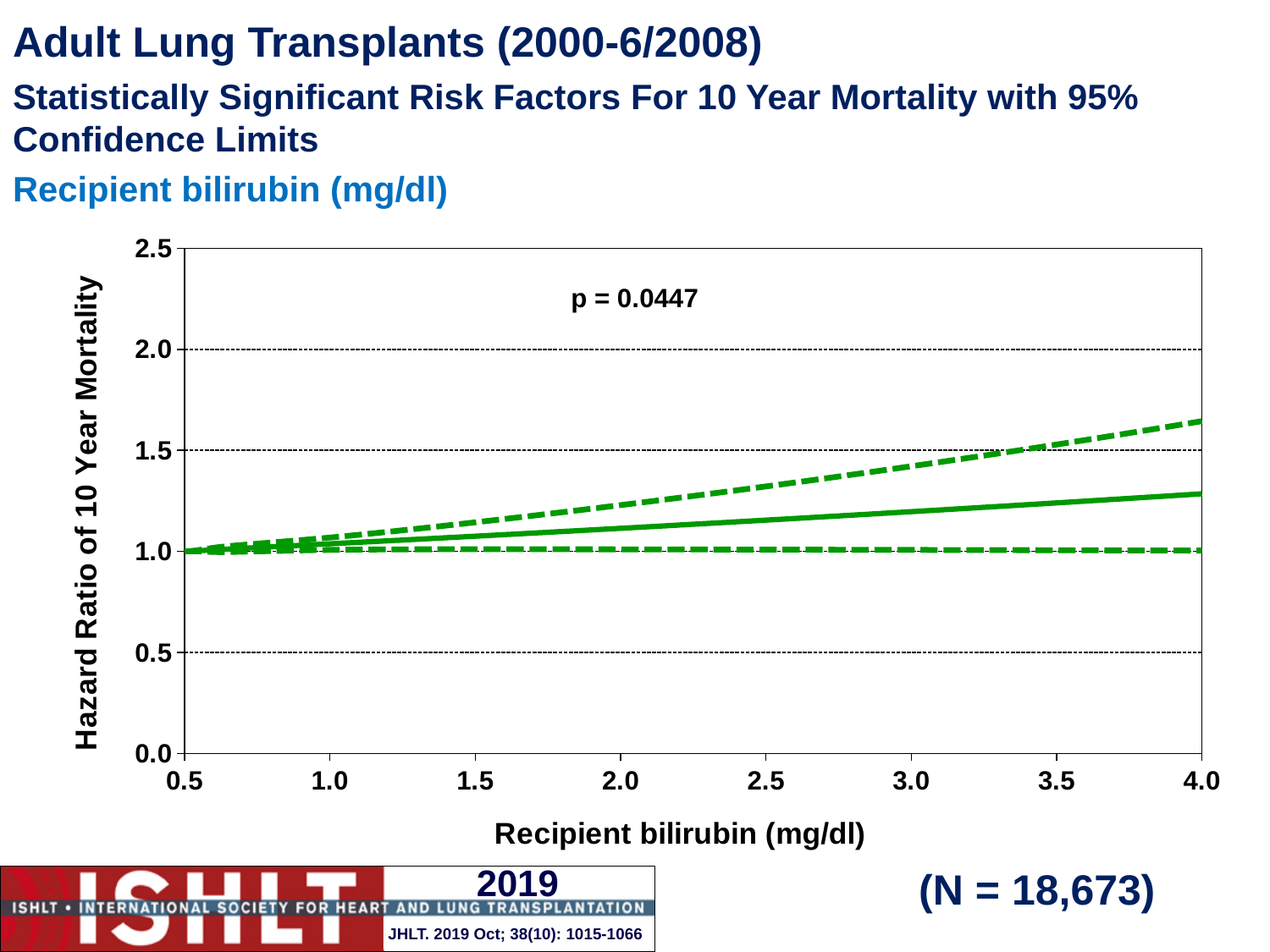
Is the value of the upper dashed confidence limit at a recipient bilirubin of 4.0 mg/dl greater or less than 1.5? greater Is the value of the solid line at a recipient bilirubin of 4.0 mg/dl greater or less than 1.5? less At a recipient bilirubin of 4.0 mg/dl, which is higher: the upper dashed confidence limit or the solid line? the upper dashed confidence limit How many lines are plotted on the chart? 3 Does the hazard ratio shown by the solid line rise or fall as recipient bilirubin increases from 0.5 to 4.0 mg/dl? rise Is the value of the upper dashed confidence limit at a recipient bilirubin of 2.0 mg/dl greater or less than 1.5? less What p-value is printed on the chart? p = 0.0447 What is the label of the y axis of the chart? Hazard Ratio of 10 Year Mortality What kind of chart is shown on the slide? line chart